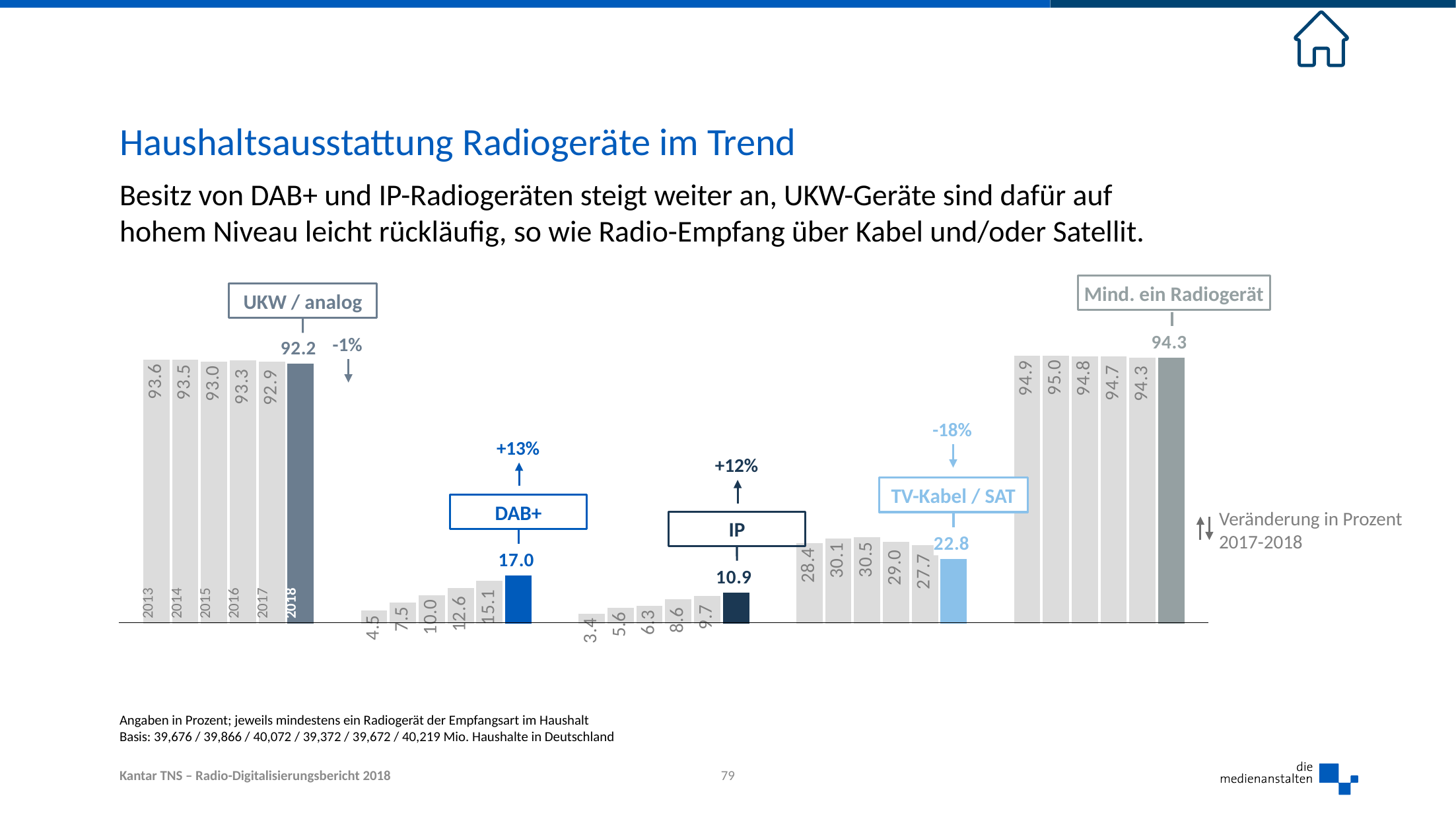
How many years are shown for each group in the chart? 6 What is the difference between the DAB+ value in 2018 and the DAB+ value in 2017? 1.9 What is the value for IP in 2013? 3.4 What is the value for DAB+ in 2018? 17.0 Which year has the lowest value for DAB+? 2013 Which is larger in 2018, the value for DAB+ or the value for IP? DAB+ Which year has the highest value for TV-Kabel / SAT? 2015 What is the percentage change from 2017 to 2018 shown for TV-Kabel / SAT? -18% What is the value for UKW / analog in 2018? 92.2 What is the value for TV-Kabel / SAT in 2018? 22.8 Do the values for IP rise or fall from 2013 to 2018? rise What kind of chart is shown on the slide? bar chart